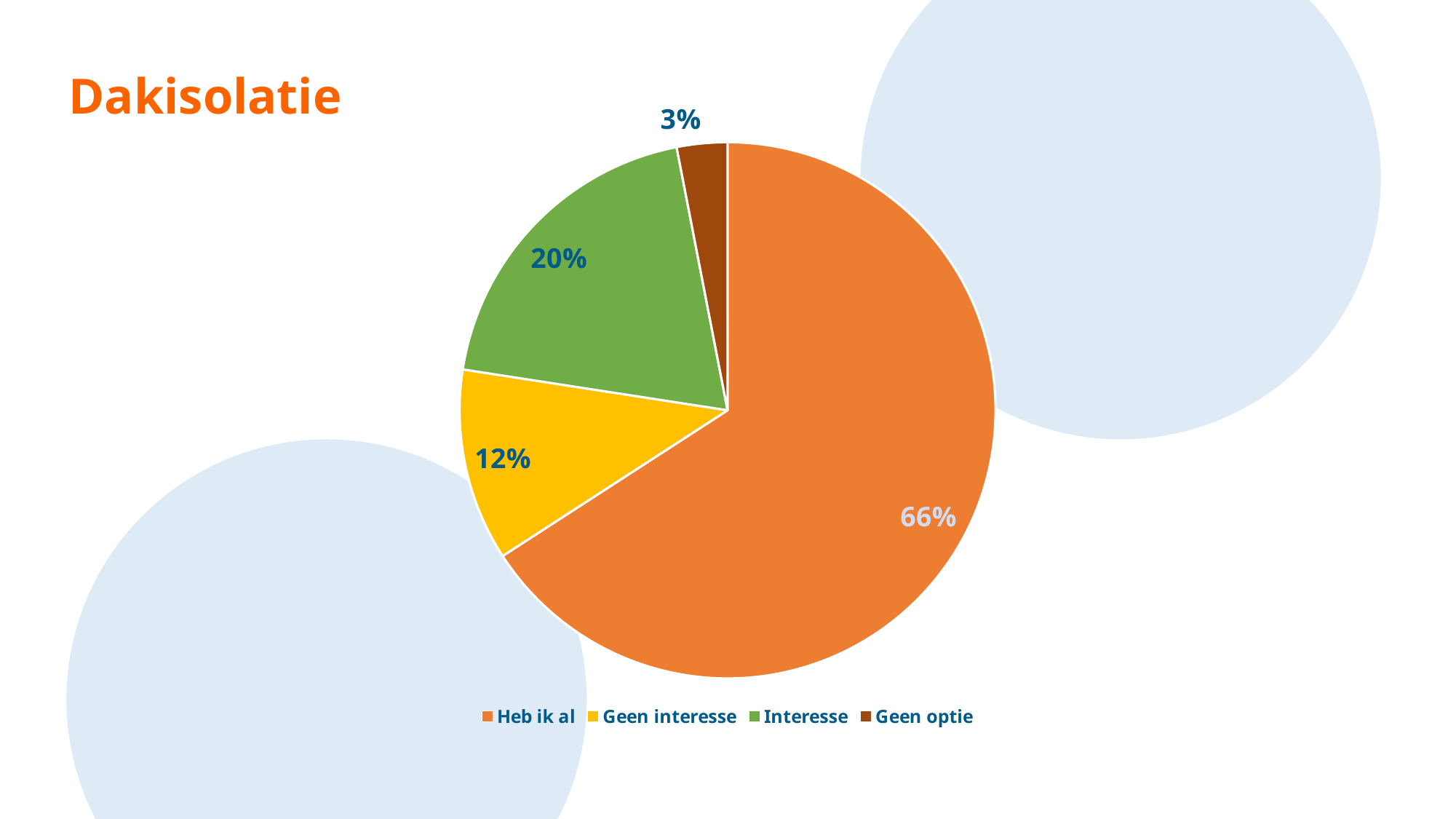
Which is larger: the share for "Interesse" or the share for "Geen interesse"? Interesse Which category has the largest slice of the pie? Heb ik al How many categories does the pie chart have? 4 What share of the pie does "Interesse" represent? 20% What share of the pie does "Geen interesse" represent? 12% What is the difference in percentage points between "Interesse" and "Geen interesse"? 8 What share of the pie does "Heb ik al" represent? 66% What colour is the slice for "Geen interesse"? yellow Which category has the smallest slice of the pie? Geen optie What kind of chart is shown on the slide? pie chart What is the title of the slide? Dakisolatie